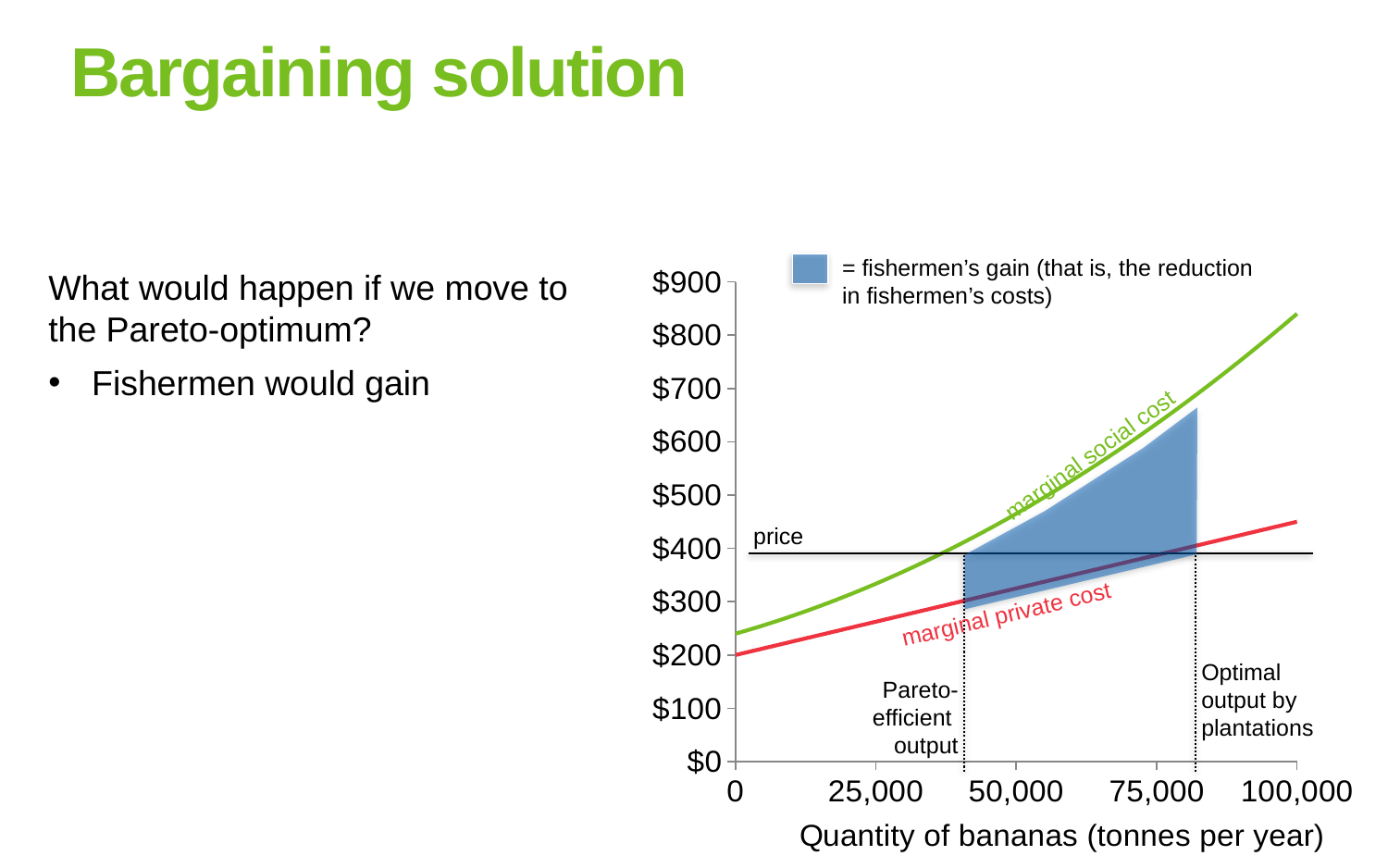
What kind of chart is shown on the slide? line chart Is the Pareto-efficient output greater or less than 50,000 tonnes per year? less Is the marginal private cost at a quantity of 100,000 greater or less than $500? less Does the marginal social cost curve rise or fall as quantity increases? rise Is the optimal output by plantations greater or less than 75,000 tonnes per year? greater Which curve is higher at a quantity of 100,000: marginal social cost or marginal private cost? marginal social cost According to the legend, what does the blue shaded area represent? fishermen's gain (the reduction in fishermen's costs) Which is larger: the Pareto-efficient output or the optimal output by plantations? optimal output by plantations What is the marginal private cost at a quantity of 0? $200 What is the title of the x axis of the chart? Quantity of bananas (tonnes per year)